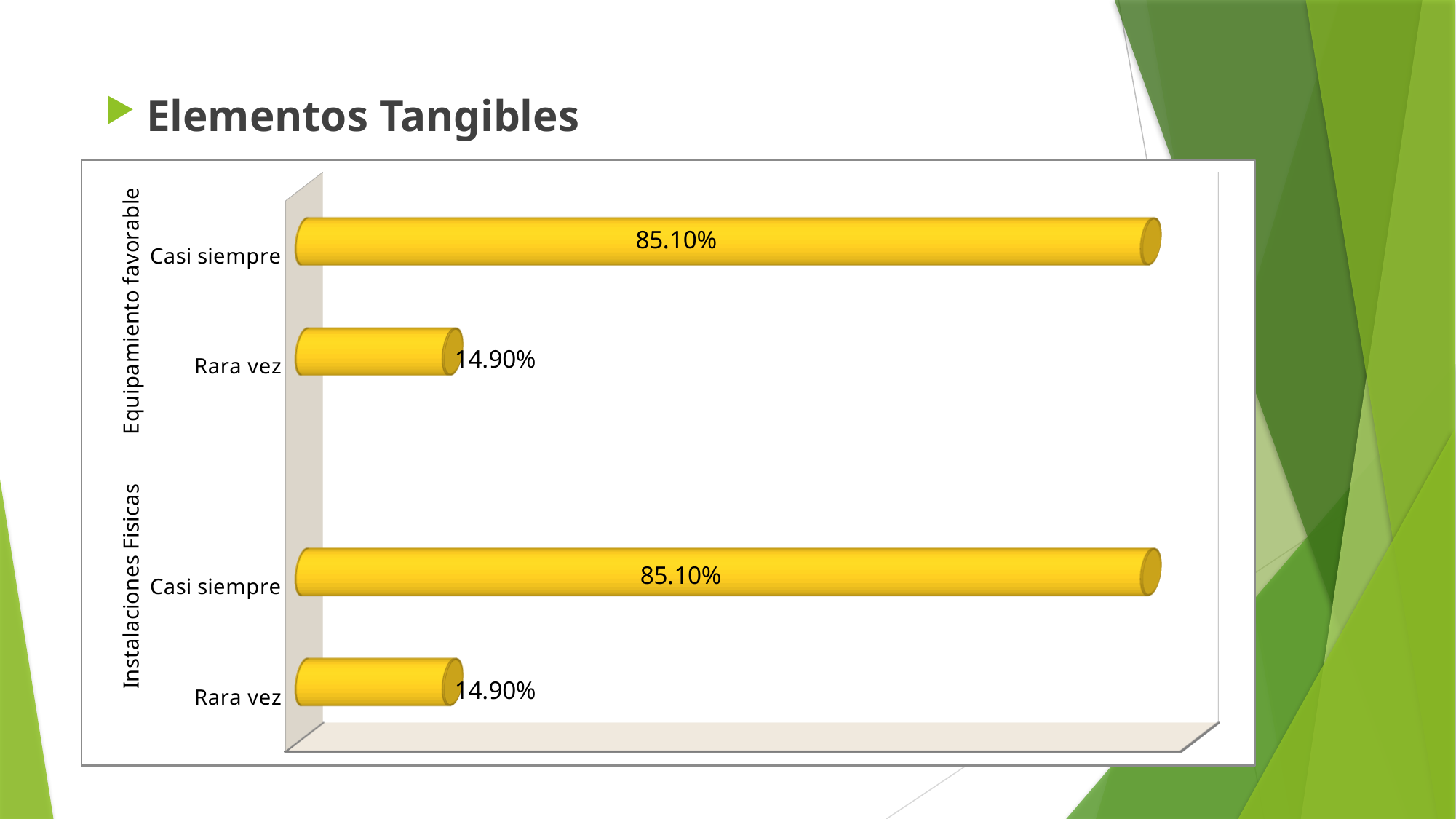
Within "Equipamiento favorable", which response has the highest value? Casi siempre What is the total of "Casi siempre" and "Rara vez" under "Instalaciones Fisicas"? 100.00% How many bars are plotted in the chart? 4 Within "Instalaciones Fisicas", which response has the lowest value? Rara vez What is the value for "Rara vez" under "Equipamiento favorable"? 14.90% What is the value for "Casi siempre" under "Instalaciones Fisicas"? 85.10% What is the title of the slide containing the chart? Elementos Tangibles What is the difference between "Casi siempre" and "Rara vez" under "Equipamiento favorable"? 70.20% What is the value for "Rara vez" under "Instalaciones Fisicas"? 14.90% Under "Instalaciones Fisicas", which is larger: "Casi siempre" or "Rara vez"? Casi siempre What kind of chart is shown on the slide? Bar chart What is the value for "Casi siempre" under "Equipamiento favorable"? 85.10%